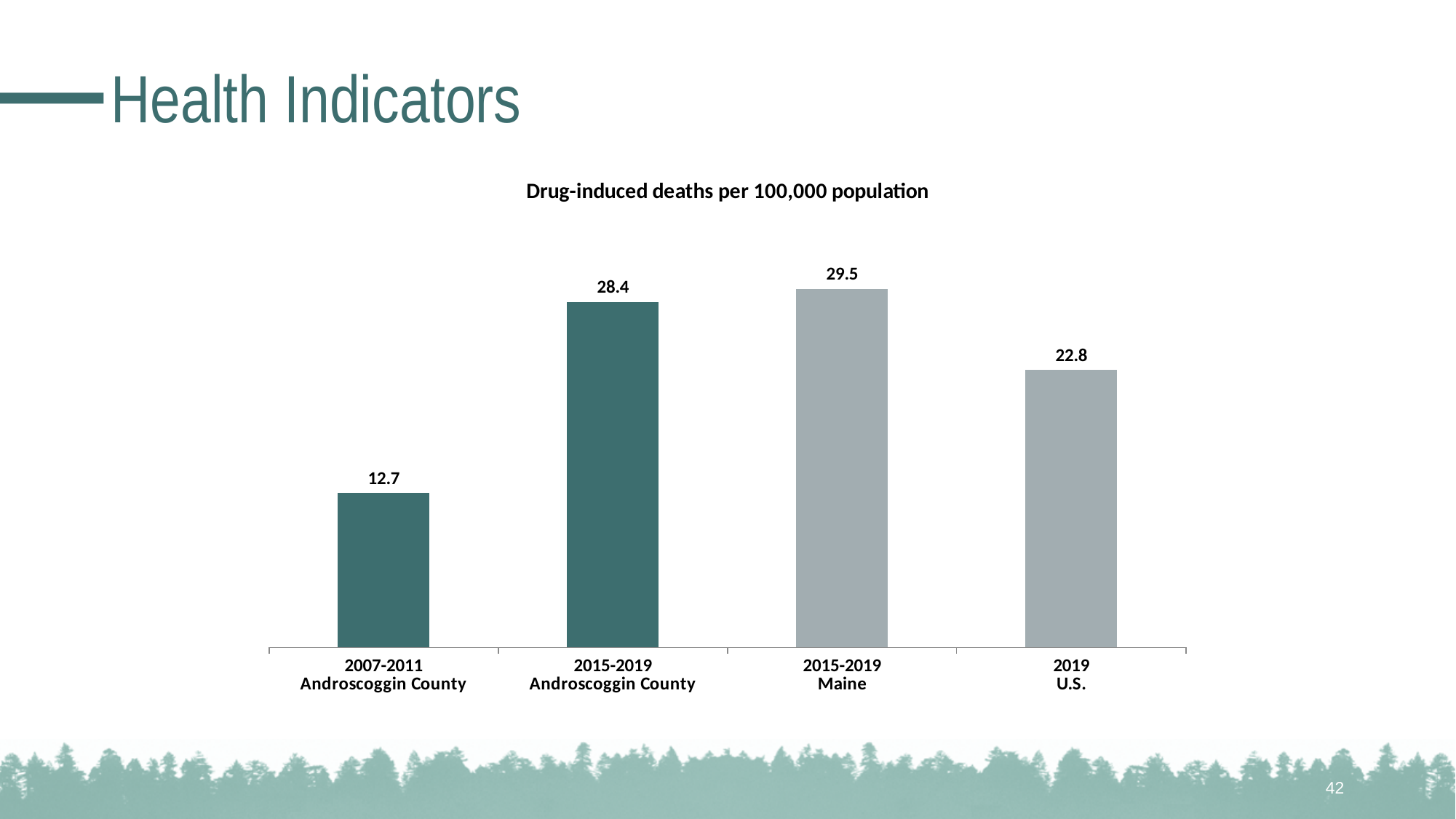
What is the value for 2015-2019 Maine? 29.5 What is the value for 2019 U.S.? 22.8 Which category has the highest value? 2015-2019 Maine What is the difference between the 2015-2019 Maine value and the 2019 U.S. value? 6.7 What is the title of the chart? Drug-induced deaths per 100,000 population What is the value for 2007-2011 Androscoggin County? 12.7 What kind of chart is shown on the slide? Bar chart How many categories are shown in the chart? 4 What is the value for 2015-2019 Androscoggin County? 28.4 Which is larger, the value for 2015-2019 Androscoggin County or the value for 2019 U.S.? 2015-2019 Androscoggin County What is the difference between the 2015-2019 Androscoggin County value and the 2007-2011 Androscoggin County value? 15.7 Which category has the lowest value? 2007-2011 Androscoggin County